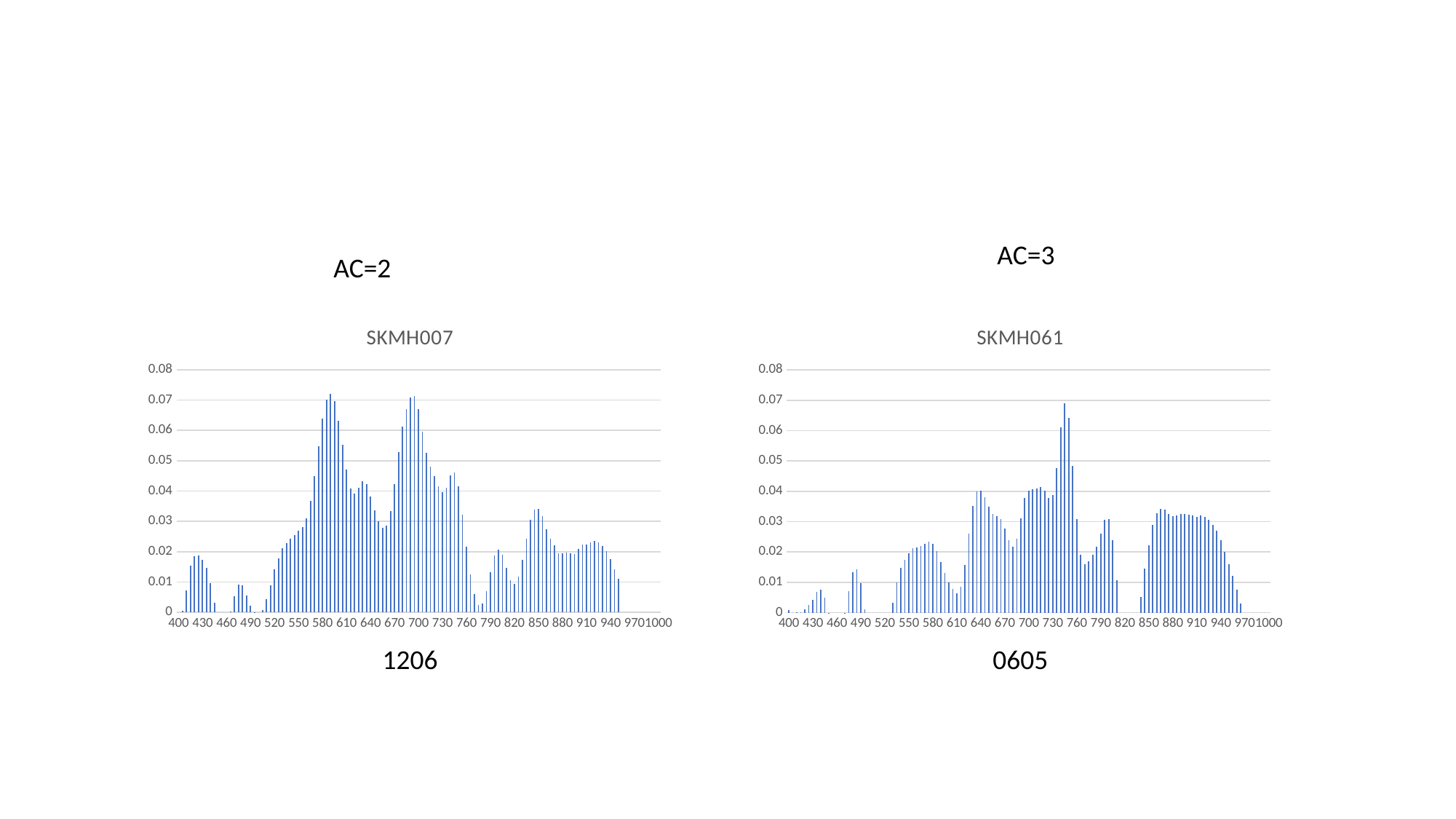
In the SKMH061 chart, is the value at 880 greater or less than 0.02? greater In the SKMH007 chart, is the value at 850 greater or less than 0.02? greater In the SKMH007 chart, is the value at 430 greater or less than 0.03? less What label appears above the SKMH061 chart on the right? AC=3 In the SKMH061 chart, which is larger, the value at 880 or the value at 430? 880 What kind of chart is the SKMH007 chart on the left? bar chart In the SKMH007 chart, which is larger, the value at 700 or the value at 790? 700 What is the title of the chart on the left side of the slide? SKMH007